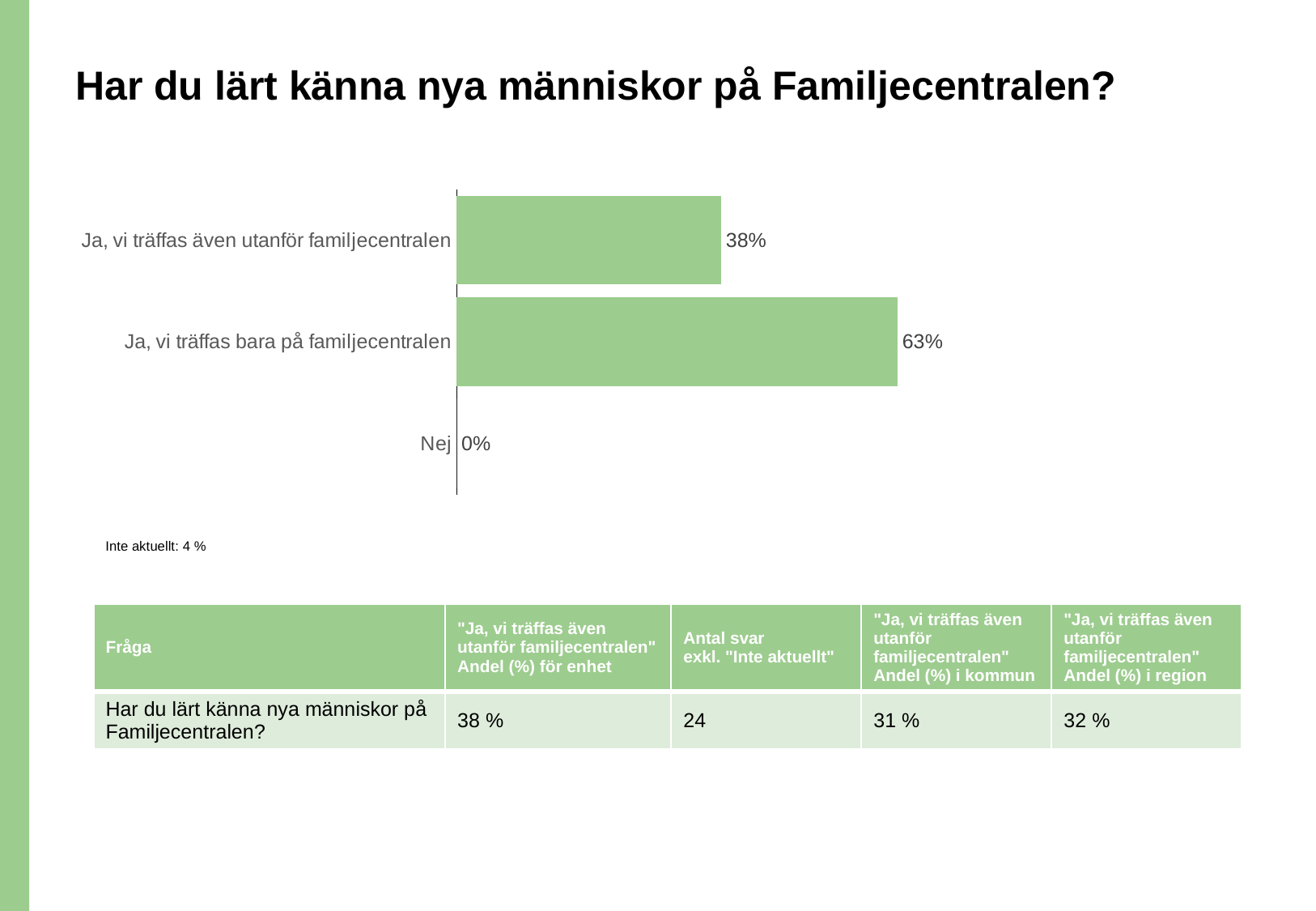
What is the difference between "Ja, vi träffas bara på familjecentralen" and "Ja, vi träffas även utanför familjecentralen"? 25% How many categories are shown in the chart? 3 Which category has the lowest value? Nej Which is larger: "Ja, vi träffas även utanför familjecentralen" or "Ja, vi träffas bara på familjecentralen"? Ja, vi träffas bara på familjecentralen What colour are the bars in the chart? Green What is the value for "Ja, vi träffas även utanför familjecentralen"? 38% What is the value for "Nej"? 0% Which category has the highest value? Ja, vi träffas bara på familjecentralen What is the value for "Ja, vi träffas bara på familjecentralen"? 63% What kind of chart is shown on the slide? Bar chart What is the title of the slide? Har du lärt känna nya människor på Familjecentralen?